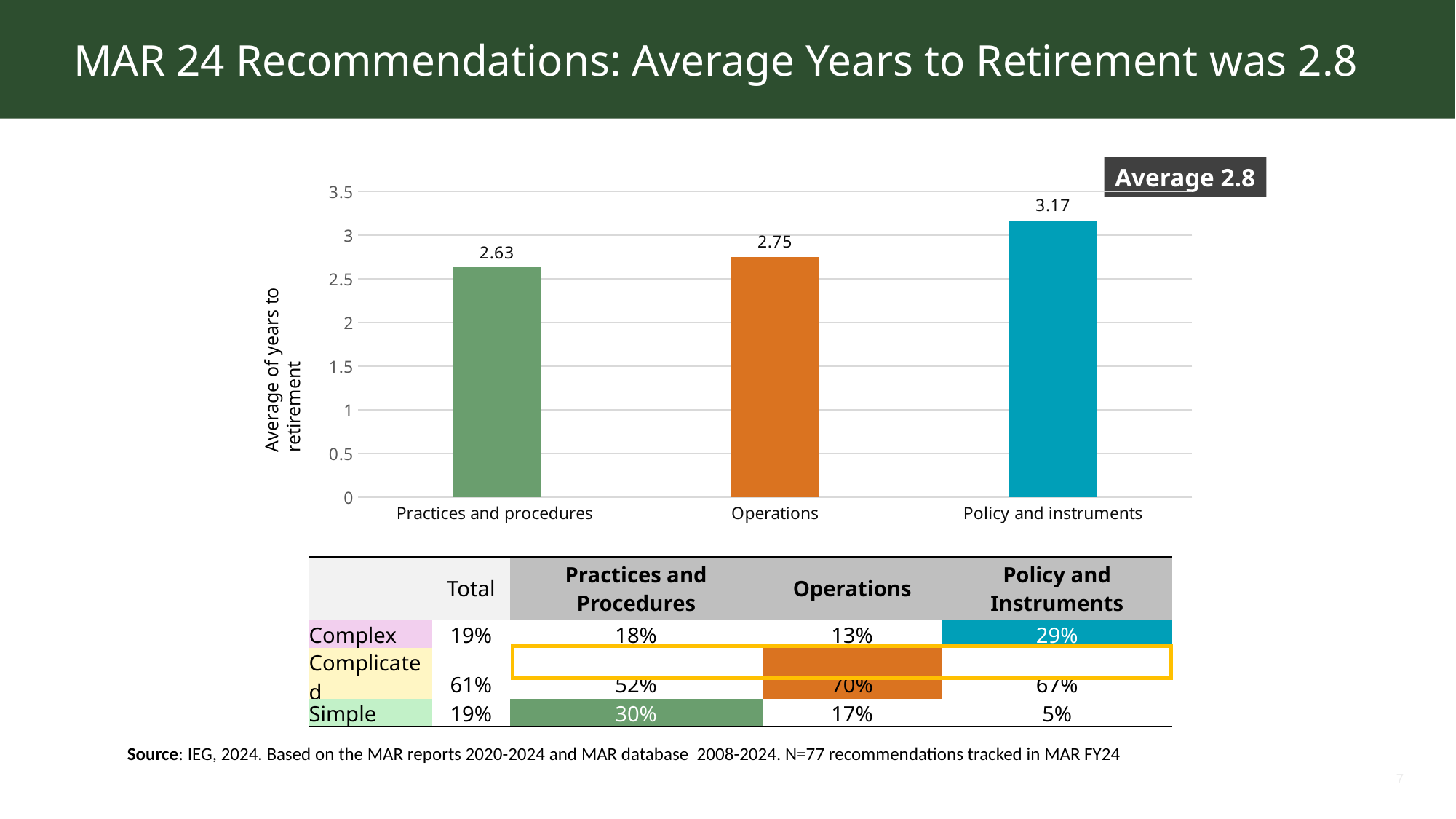
What is the average years to retirement for Policy and instruments? 3.17 What type of chart is shown on the slide? Bar chart How many categories are shown in the bar chart? 3 What is the average years to retirement for Practices and procedures? 2.63 What is the label of the y axis of the chart? Average of years to retirement What is the average years to retirement for Operations? 2.75 Which category has the lowest average years to retirement? Practices and procedures What is the difference in average years to retirement between Operations and Practices and procedures? 0.12 What is the difference in average years to retirement between Policy and instruments and Practices and procedures? 0.54 Which has a higher average years to retirement, Operations or Policy and instruments? Policy and instruments Is the value for Policy and instruments greater or less than 3? greater Which category has the highest average years to retirement? Policy and instruments